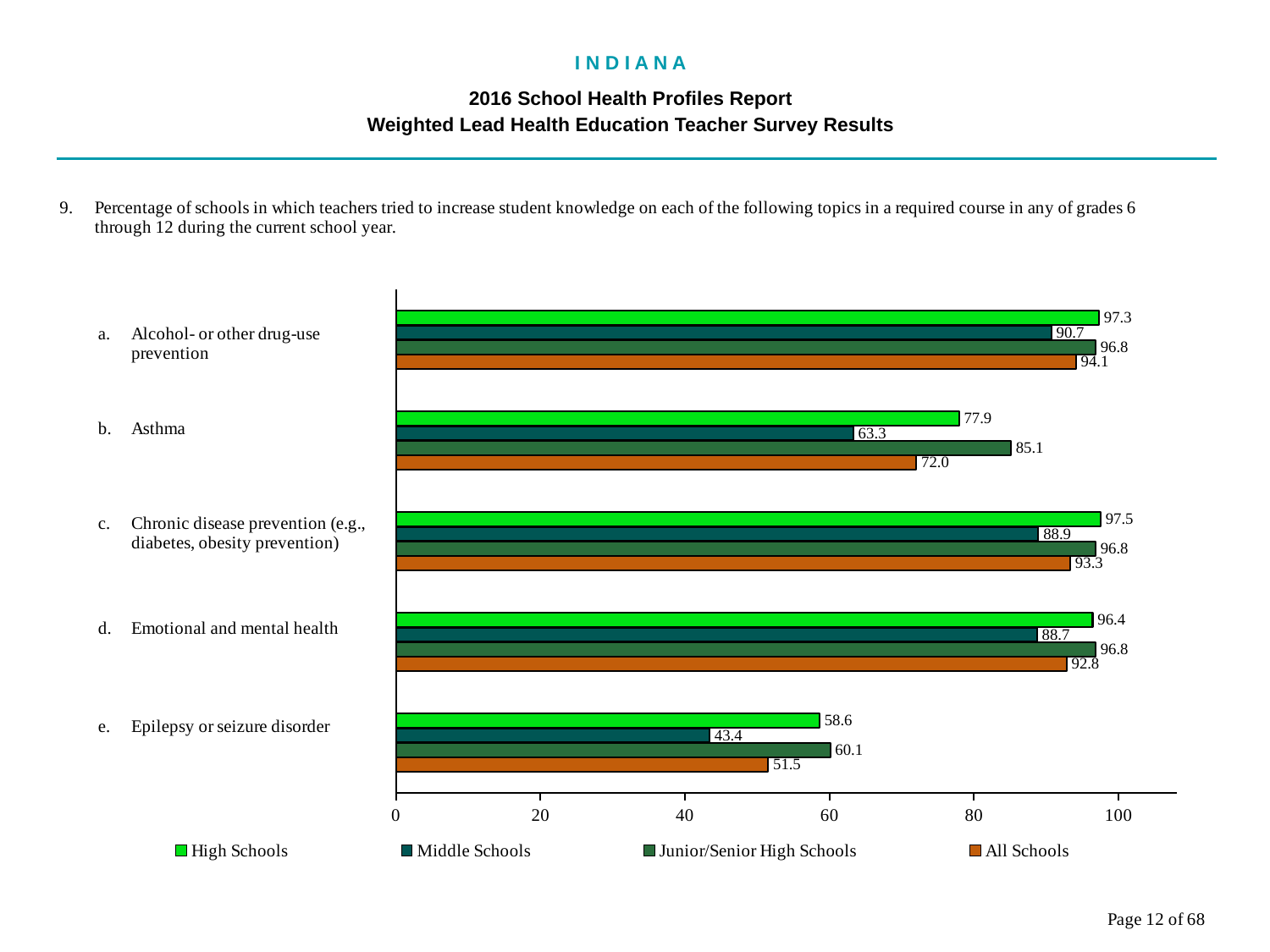
Which series is shown in orange in the legend? All Schools What is the value for Middle Schools for Asthma? 63.3 Which topic has the lowest value for Middle Schools? Epilepsy or seizure disorder What is the value for Junior/Senior High Schools for Alcohol- or other drug-use prevention? 96.8 How many series does the legend list? 4 Is the value for Junior/Senior High Schools for Epilepsy or seizure disorder greater or less than 80? less What is the difference between the High Schools and Middle Schools values for Asthma? 14.6 How many topics are shown on the chart? 5 Which is larger for Emotional and mental health: the High Schools value or the Junior/Senior High Schools value? Junior/Senior High Schools What is the value for All Schools for Epilepsy or seizure disorder? 51.5 Which topic has the highest value for High Schools? Chronic disease prevention (e.g., diabetes, obesity prevention) What kind of chart is shown on the slide? bar chart